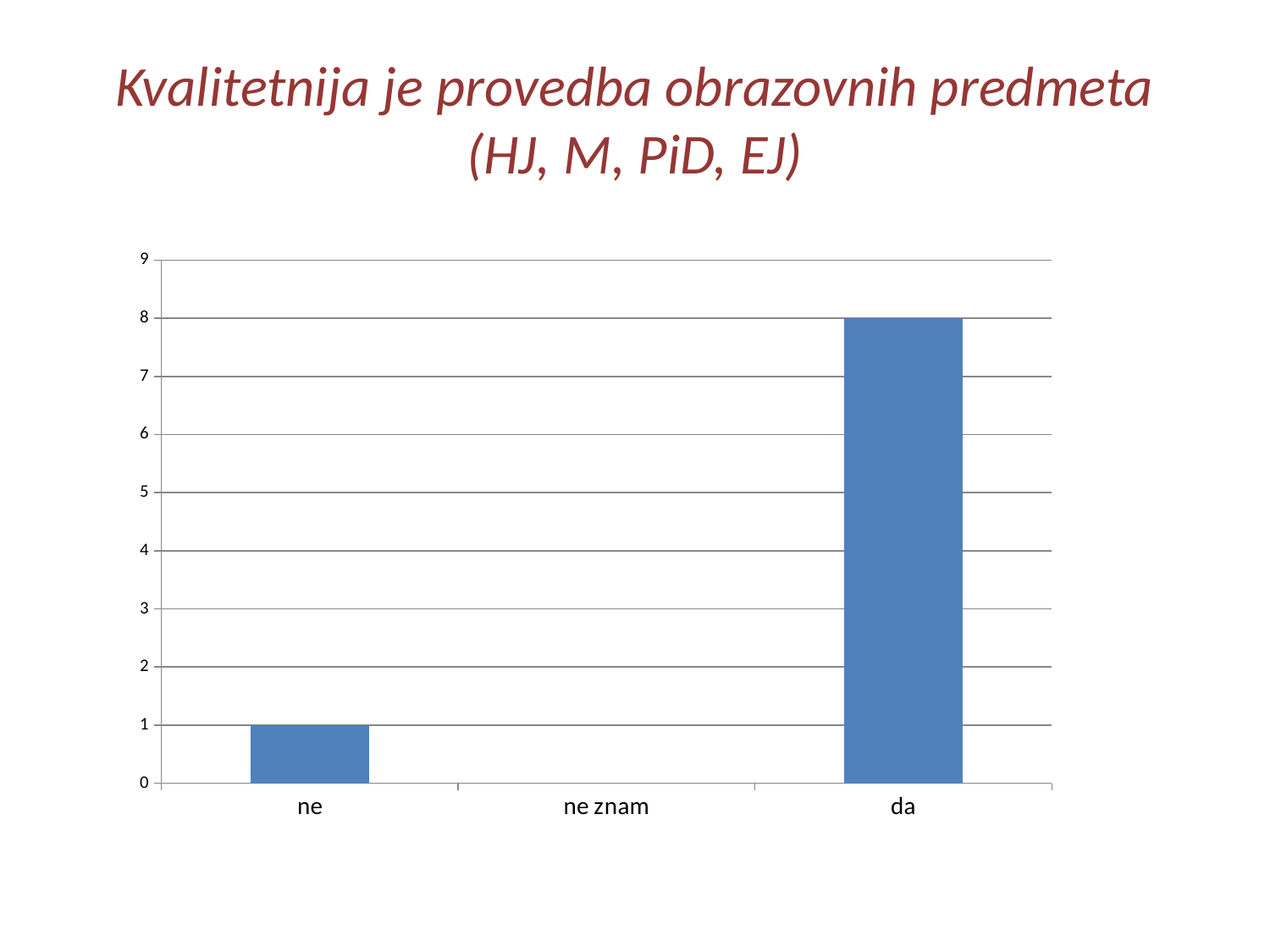
What is the difference between the values for "da" and "ne"? 7 What is the value for "ne znam"? 0 Is the value for "da" greater or less than 5? greater Which category has the highest value? da What is the value for "ne"? 1 What is the title of the chart on the slide? Kvalitetnija je provedba obrazovnih predmeta (HJ, M, PiD, EJ) Which is larger, the value for "ne" or the value for "da"? da Which category has the lowest value? ne znam What is the value for "da"? 8 What type of chart is shown on the slide? bar chart What is the highest value shown on the vertical axis? 9 How many categories are shown on the x axis of the chart? 3